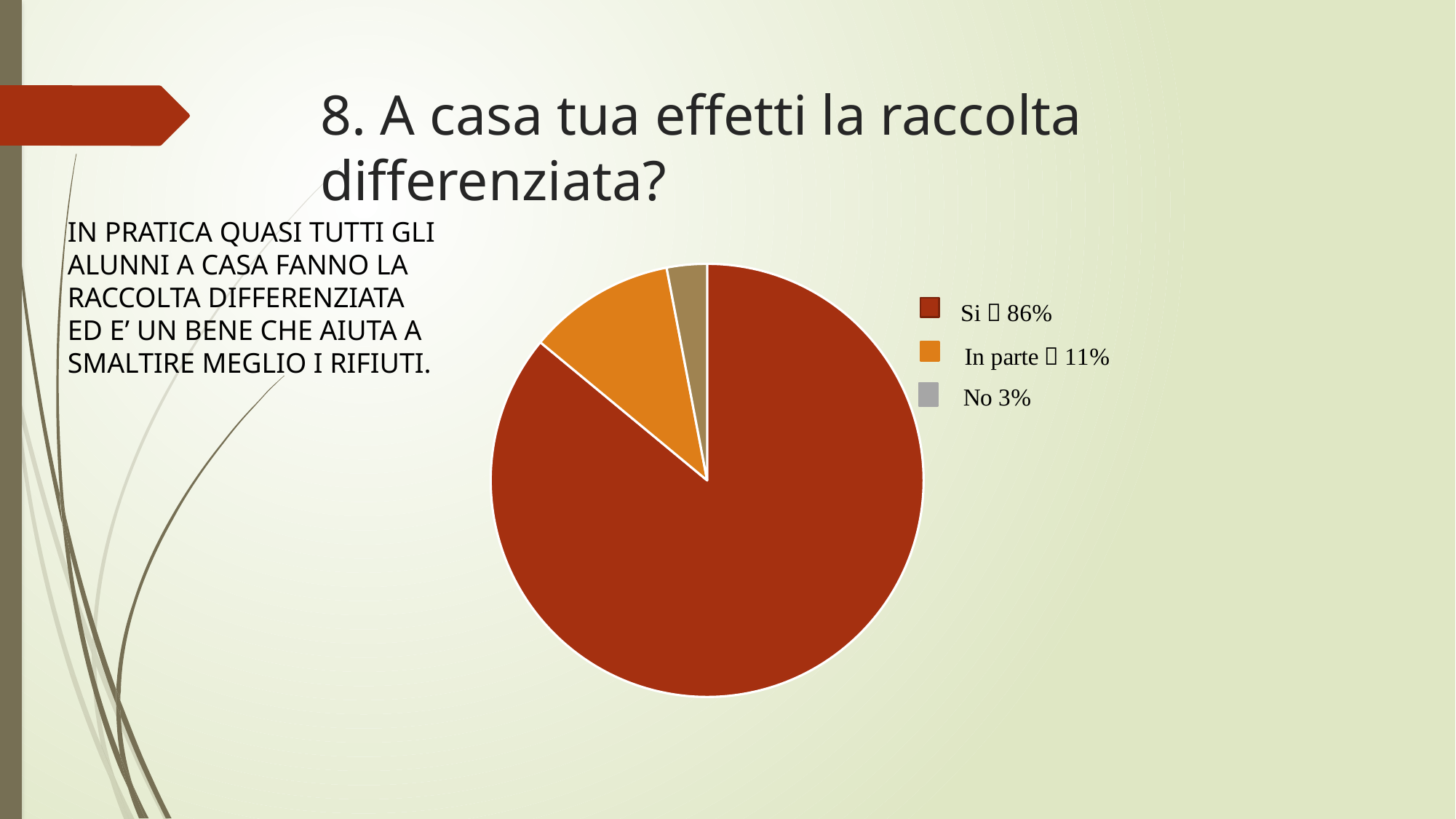
What percentage of the pie corresponds to "In parte"? 11% Which category has the smallest slice of the pie? No Which category has the largest slice of the pie? Si What percentage of the pie corresponds to "Si"? 86% How many slices does the pie chart have? 3 What percentage of the pie corresponds to "No"? 3% What is the difference in percentage points between "Si" and "In parte"? 75 What is the difference in percentage points between "In parte" and "No"? 8 Which is larger, the share for "In parte" or the share for "No"? In parte What colour is the slice for "In parte"? orange What kind of chart is shown on the slide? pie chart